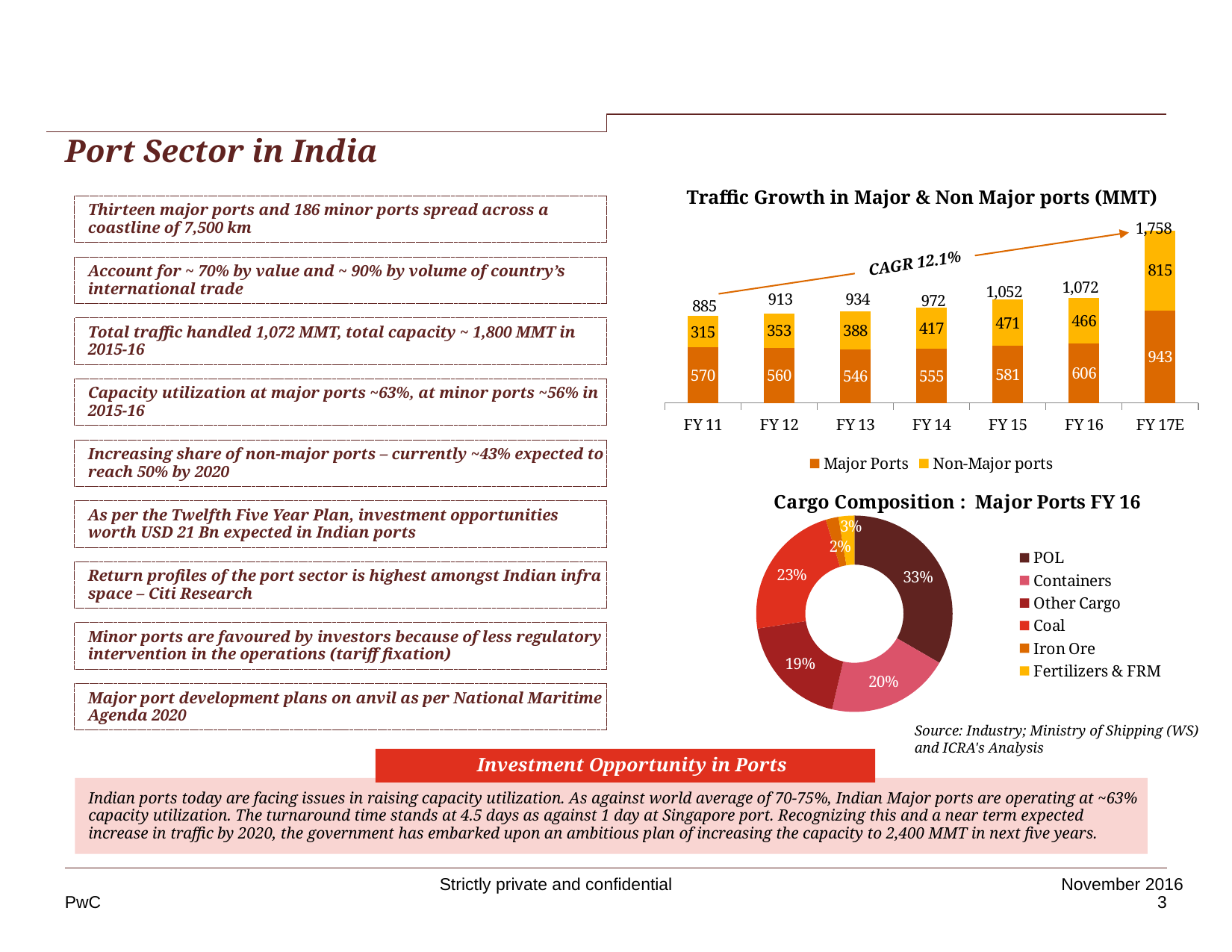
In the 'Traffic Growth in Major & Non Major ports (MMT)' chart, what is the value for Non-Major ports in FY 14? 417 In the 'Cargo Composition : Major Ports FY 16' chart, which category has the largest share? POL In the 'Traffic Growth in Major & Non Major ports (MMT)' chart, what is the total traffic shown for FY 17E? 1,758 What CAGR is annotated on the 'Traffic Growth in Major & Non Major ports (MMT)' chart? CAGR 12.1% How many years are shown on the x axis of the 'Traffic Growth in Major & Non Major ports (MMT)' chart? 7 In the 'Traffic Growth in Major & Non Major ports (MMT)' chart, what is the value for Major Ports in FY 16? 606 In the 'Traffic Growth in Major & Non Major ports (MMT)' chart, which is larger in FY 15: Major Ports or Non-Major ports? Major Ports How many series does the legend of the 'Traffic Growth in Major & Non Major ports (MMT)' chart list? 2 In the 'Cargo Composition : Major Ports FY 16' chart, what share does Coal have? 23% In the 'Traffic Growth in Major & Non Major ports (MMT)' chart, which year has the lowest total traffic? FY 11 What kind of chart is 'Traffic Growth in Major & Non Major ports (MMT)'? Stacked bar chart In the 'Traffic Growth in Major & Non Major ports (MMT)' chart, what is the difference between the Major Ports values for FY 17E and FY 16? 337